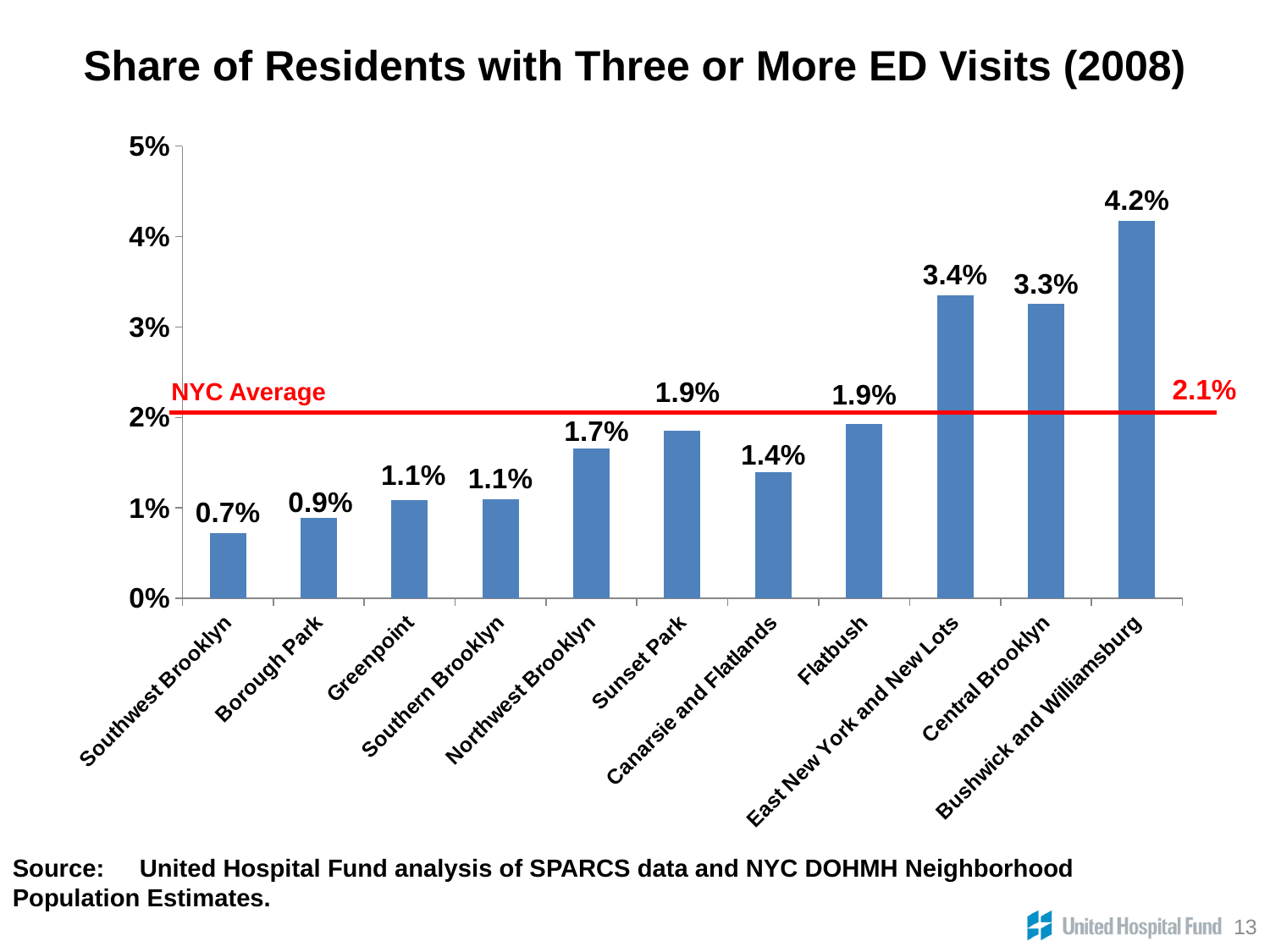
What kind of chart is shown on the slide? Bar chart What is the difference between the values for Bushwick and Williamsburg and East New York and New Lots? 0.8% Is the value for Central Brooklyn greater or less than 3%? greater Which has a larger value, Northwest Brooklyn or Borough Park? Northwest Brooklyn How many neighborhoods are shown on the chart? 11 Which neighborhood has the highest share of residents with three or more ED visits? Bushwick and Williamsburg What is the share of residents with three or more ED visits in Bushwick and Williamsburg? 4.2% What is the value shown for Southwest Brooklyn? 0.7% What is the title of the chart? Share of Residents with Three or More ED Visits (2008) What is the value shown for Canarsie and Flatlands? 1.4% Which neighborhood has the lowest share of residents with three or more ED visits? Southwest Brooklyn What is the NYC Average value marked by the red line? 2.1%